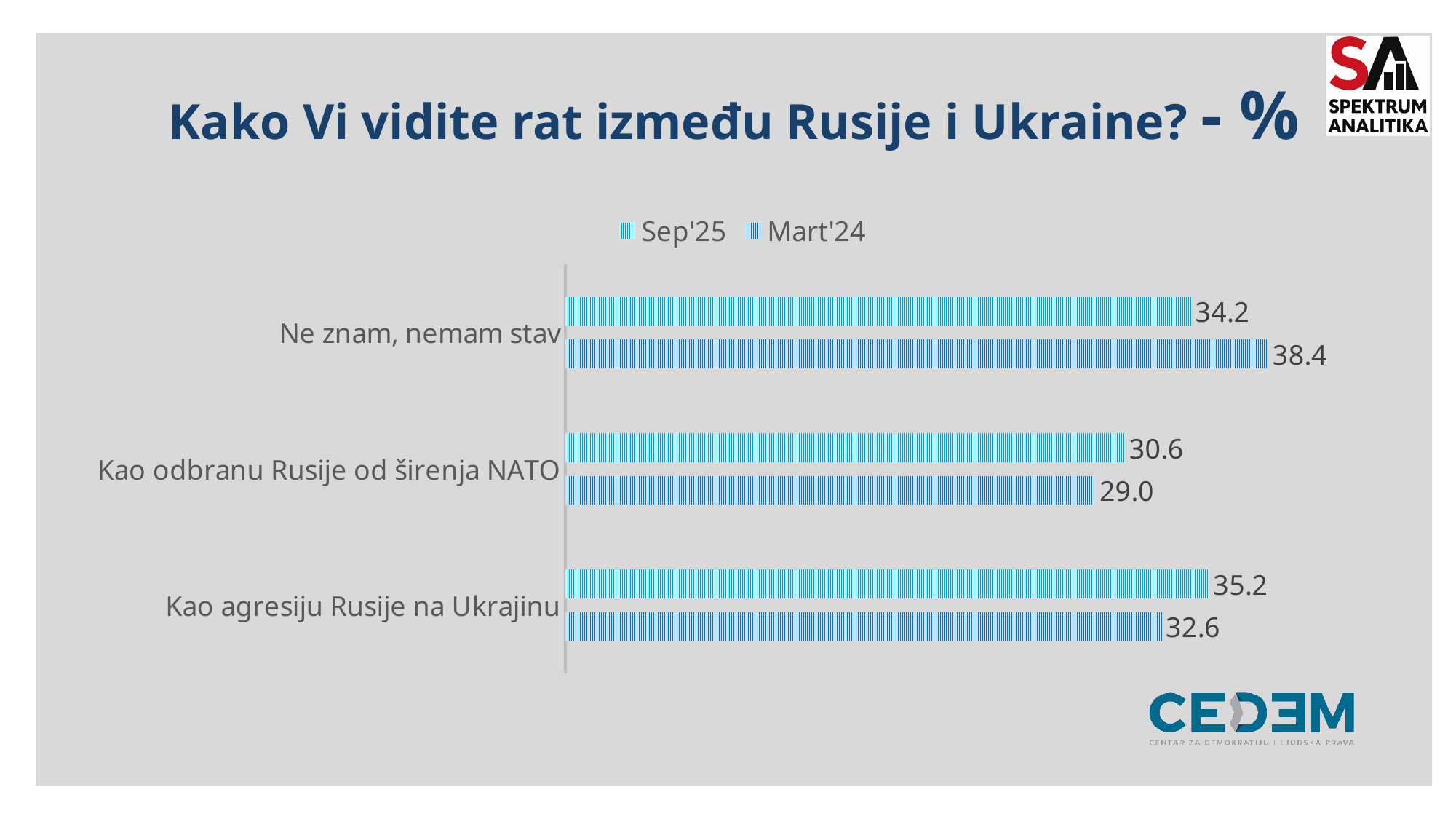
Which category has the lowest Sep'25 value? Kao odbranu Rusije od širenja NATO What is the Mart'24 value for "Kao odbranu Rusije od širenja NATO"? 29.0 What is the Mart'24 value for "Ne znam, nemam stav"? 38.4 For "Kao odbranu Rusije od širenja NATO", which is larger: the Sep'25 value or the Mart'24 value? Sep'25 How many series does the legend list? 2 How many categories are shown on the chart? 3 What is the difference between the Sep'25 and Mart'24 values for "Kao agresiju Rusije na Ukrajinu"? 2.6 What is the difference between the Mart'24 and Sep'25 values for "Ne znam, nemam stav"? 4.2 What is the Sep'25 value for "Ne znam, nemam stav"? 34.2 What is the Sep'25 value for "Kao agresiju Rusije na Ukrajinu"? 35.2 Which category has the highest Mart'24 value? Ne znam, nemam stav What kind of chart is shown on the slide? Bar chart